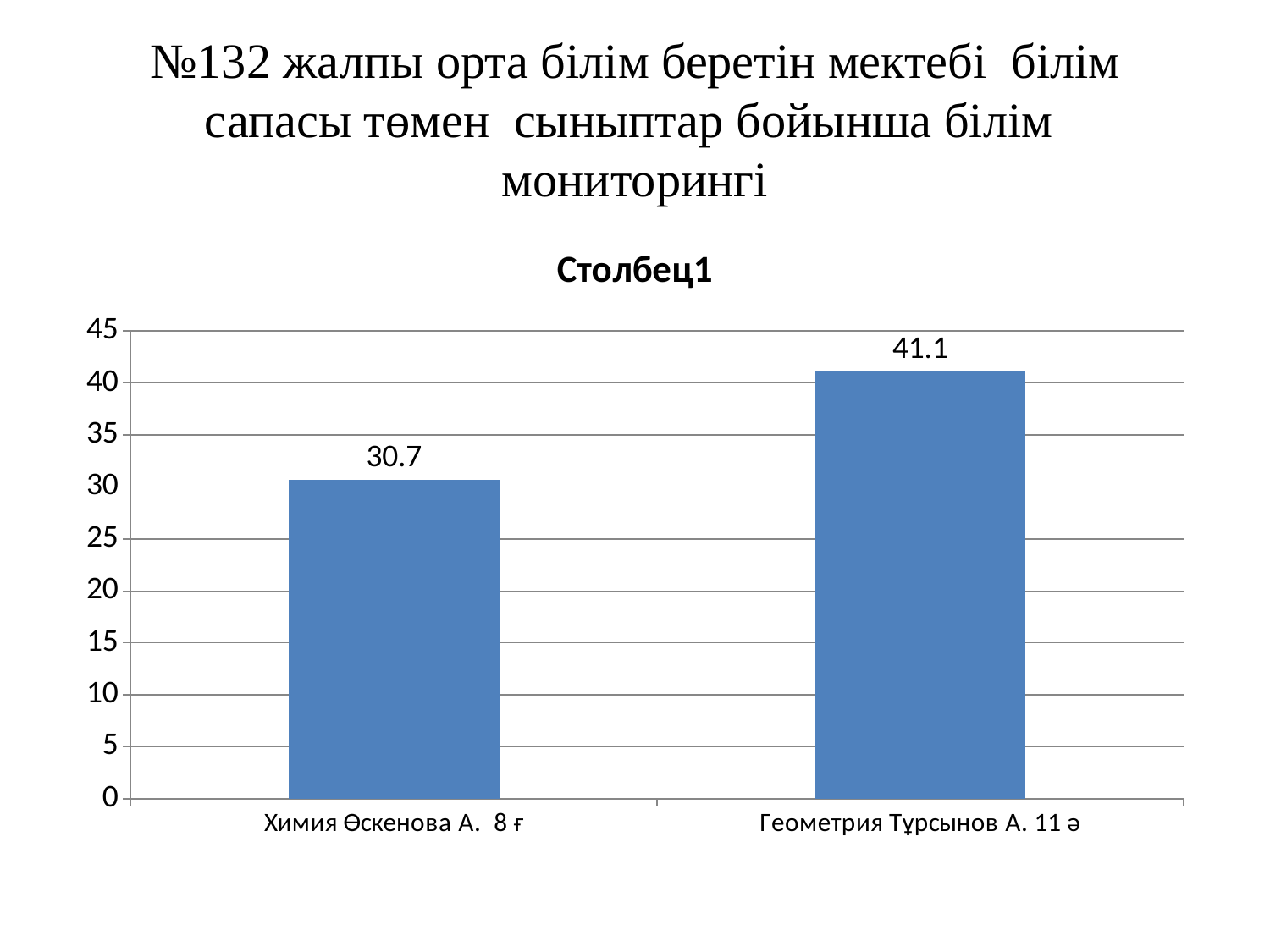
What is the value for Геометрия Тұрсынов А. 11 ә? 41.1 Which category has the highest value? Геометрия Тұрсынов А. 11 ә What is the value for Химия Өскенова А. 8 ғ? 30.7 What kind of chart is shown on the slide? bar chart What is the maximum value shown on the vertical axis? 45 Is the value for Химия Өскенова А. 8 ғ greater or less than 35? less What is the title of the chart? Столбец1 How many categories are shown on the chart? 2 Which category has the lowest value? Химия Өскенова А. 8 ғ What is the difference between the values for Геометрия Тұрсынов А. 11 ә and Химия Өскенова А. 8 ғ? 10.4 Which is larger: the value for Химия Өскенова А. 8 ғ or the value for Геометрия Тұрсынов А. 11 ә? Геометрия Тұрсынов А. 11 ә Is the value for Геометрия Тұрсынов А. 11 ә greater or less than 40? greater